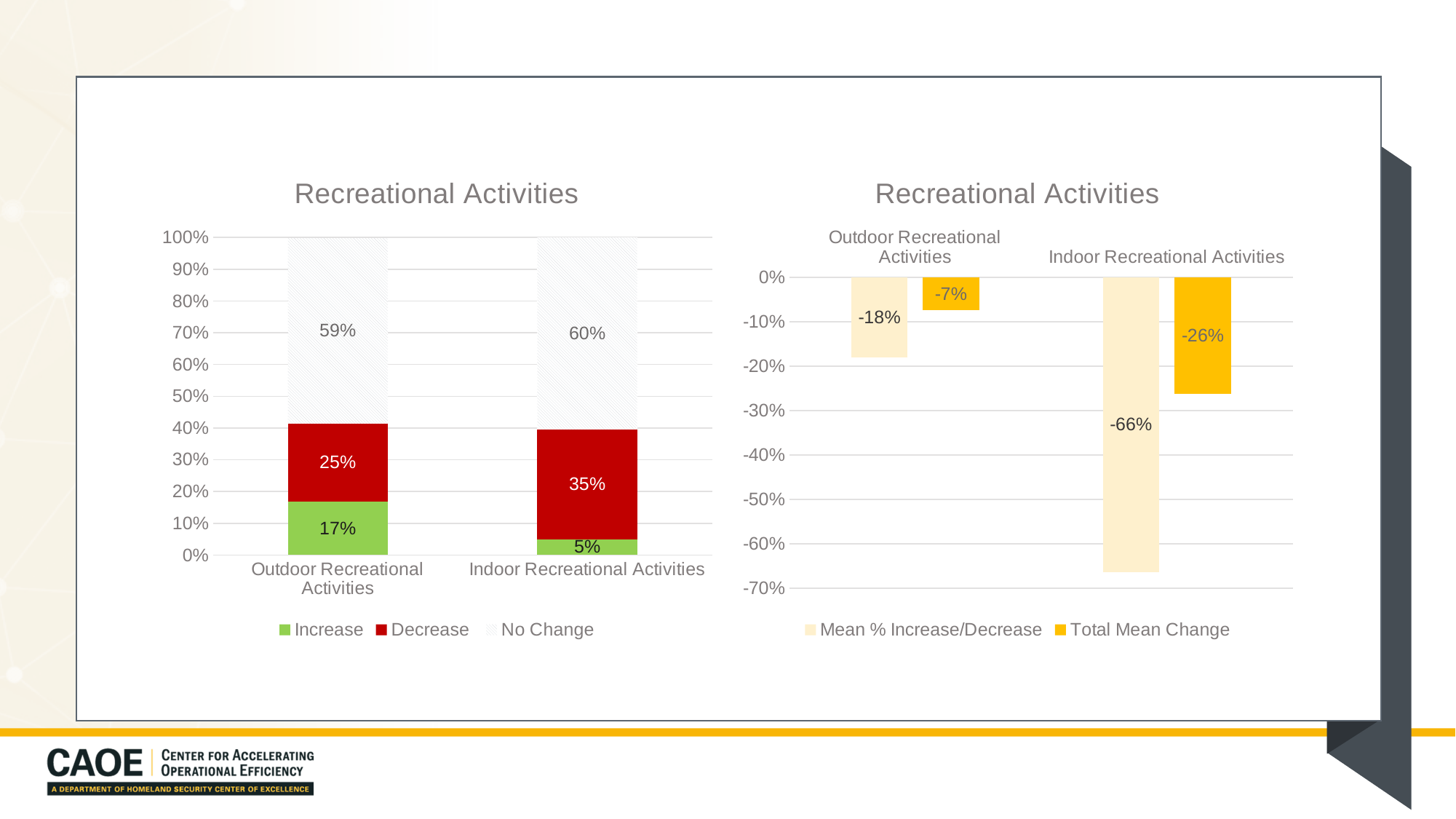
In the right chart, what is the difference between the Mean % Increase/Decrease for Outdoor and Indoor Recreational Activities? 48 percentage points In the left chart, what percentage of respondents reported a Decrease for Outdoor Recreational Activities? 25% In the right chart, what is the Total Mean Change for Outdoor Recreational Activities? -7% How many series does the legend of the left chart list? 3 In the left chart, what is the No Change value for Indoor Recreational Activities? 60% In the left chart, how many percentage points higher is the Decrease share for Indoor Recreational Activities than for Outdoor Recreational Activities? 10 percentage points In the right chart, what is the Mean % Increase/Decrease for Indoor Recreational Activities? -66% In the right chart, which category has the lowest Mean % Increase/Decrease value? Indoor Recreational Activities What type of chart is the left chart? Stacked bar chart How many categories are shown on the x axis of the right chart? 2 In the left chart, what is the Increase value for Indoor Recreational Activities? 5% In the left chart, which category has the larger Decrease share, Outdoor Recreational Activities or Indoor Recreational Activities? Indoor Recreational Activities